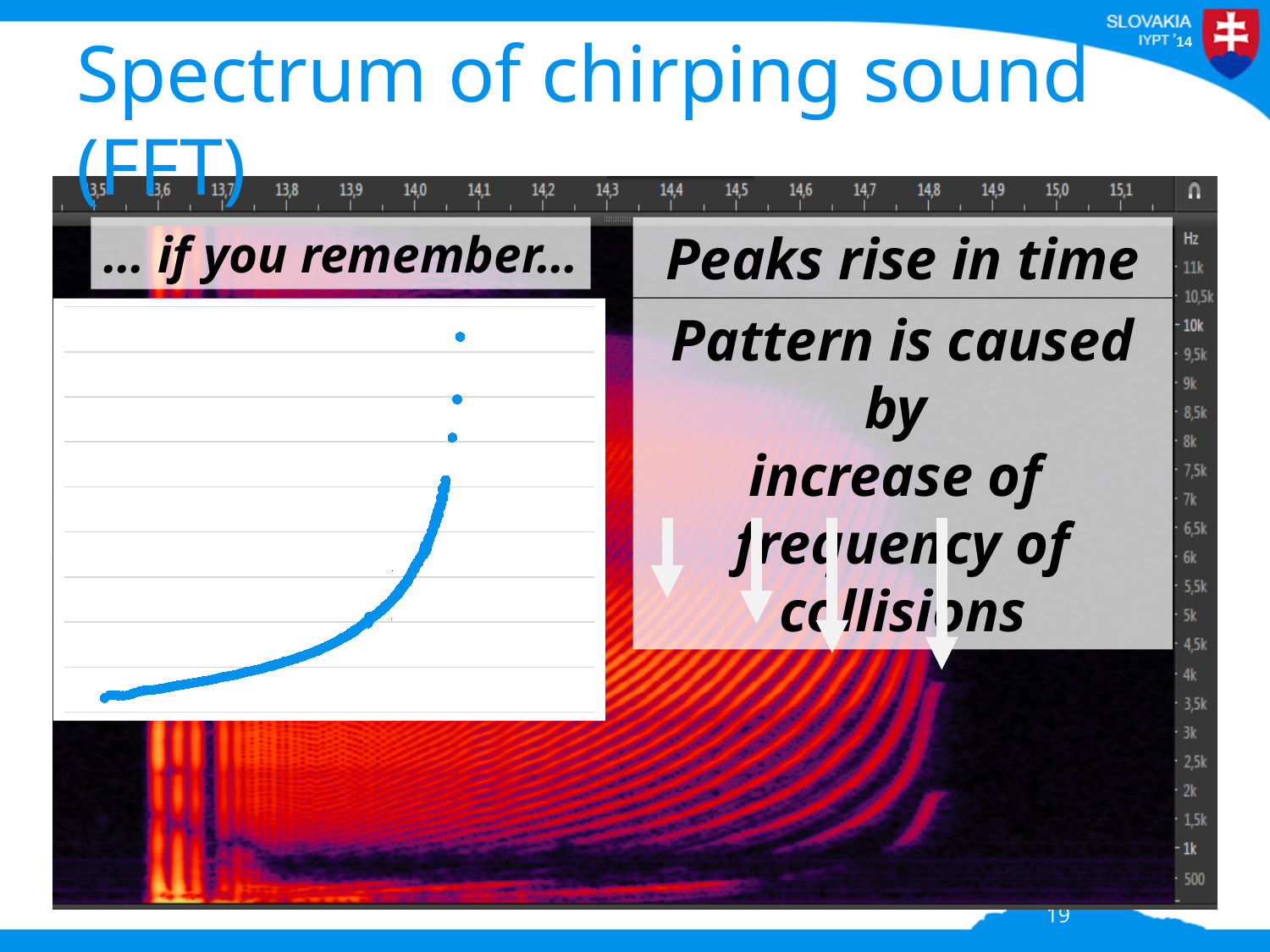
In the scatter chart on the left, do the plotted values rise or fall from left to right along the x axis? rise What kind of chart is the white-background chart on the left side of the slide? scatter chart Does the scatter chart on the left show a legend? no What colour are the plotted points in the scatter chart on the left? blue